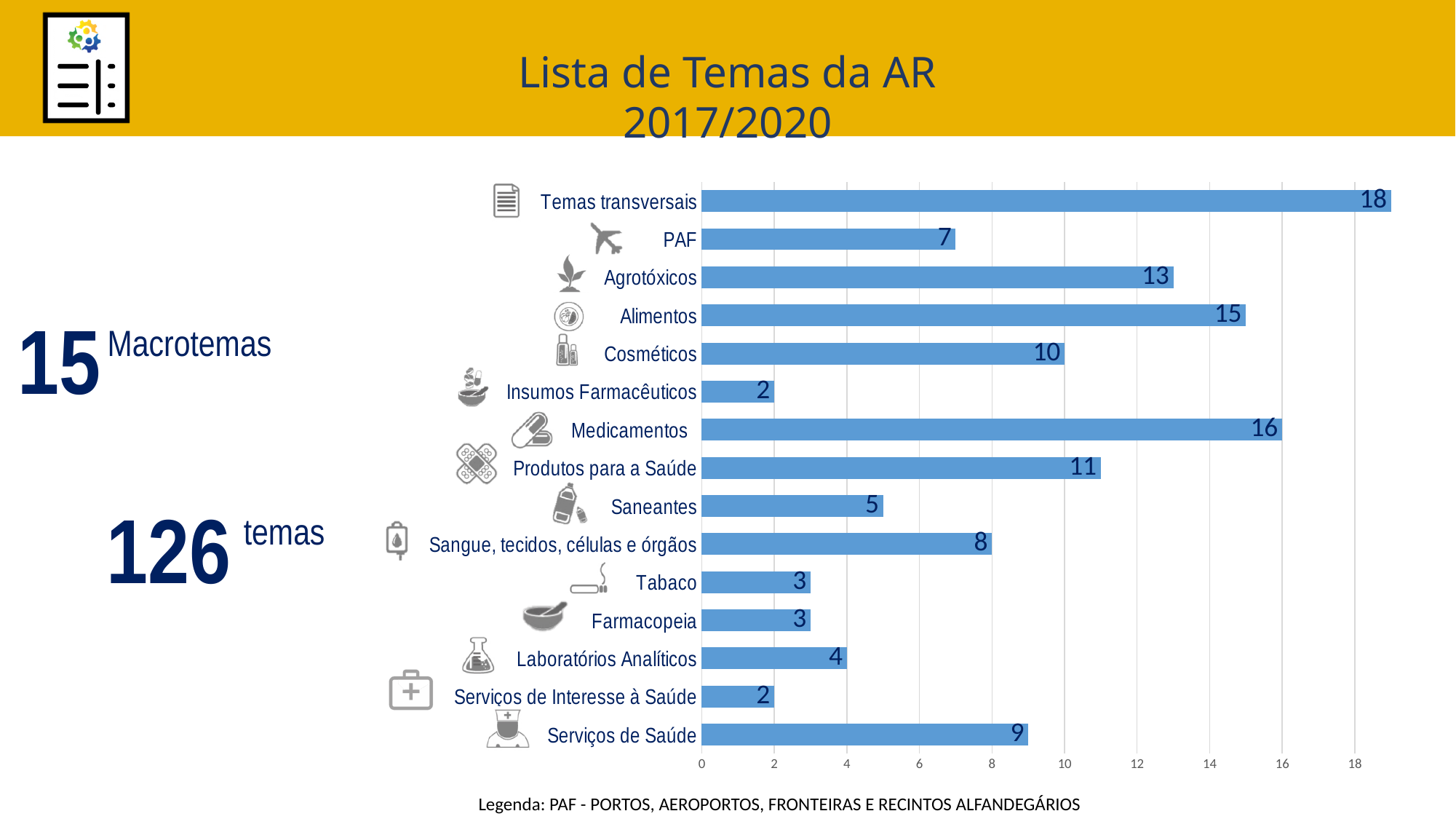
Which category has the highest value? Temas transversais What is the value for Sangue, tecidos, células e órgãos? 8 What kind of chart is shown on the slide? bar chart What is the difference between the values for Temas transversais and Insumos Farmacêuticos? 16 How many categories are shown in the chart? 15 What is the value for Temas transversais? 18 Is the value for Serviços de Saúde greater or less than 10? less Which is larger, the value for Cosméticos or the value for Produtos para a Saúde? Produtos para a Saúde What is the difference between the values for Alimentos and Agrotóxicos? 2 What does the legend at the bottom of the slide say PAF stands for? PORTOS, AEROPORTOS, FRONTEIRAS E RECINTOS ALFANDEGÁRIOS What is the value for Laboratórios Analíticos? 4 What is the value for Medicamentos? 16